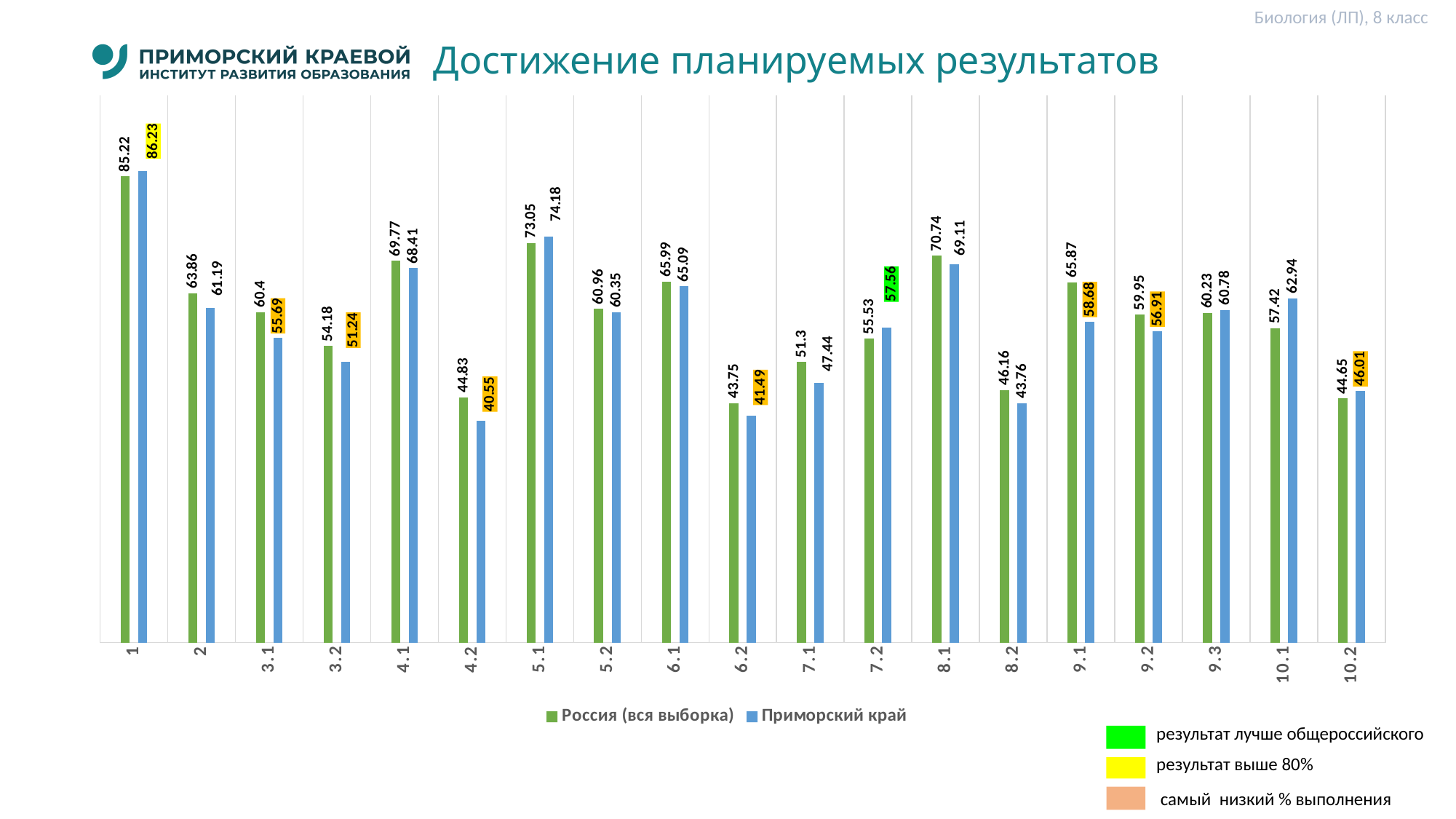
What is the value for Приморский край in category 10.1? 62.94 In category 7.2, which series has the larger value, Россия (вся выборка) or Приморский край? Приморский край How many categories are shown on the x axis of the chart? 19 What is the value for Россия (вся выборка) in category 7.1? 51.3 Which category has the highest value for Россия (вся выборка)? 1 What is the title of the chart on the slide? Достижение планируемых результатов Which category has the lowest value for Приморский край? 4.2 In category 4.2, which series has the larger value, Россия (вся выборка) or Приморский край? Россия (вся выборка) What is the difference between Россия (вся выборка) and Приморский край in category 9.1? 7.19 How many series does the chart legend list? 2 What kind of chart is shown on the slide? bar chart What is the value for Приморский край in category 1? 86.23